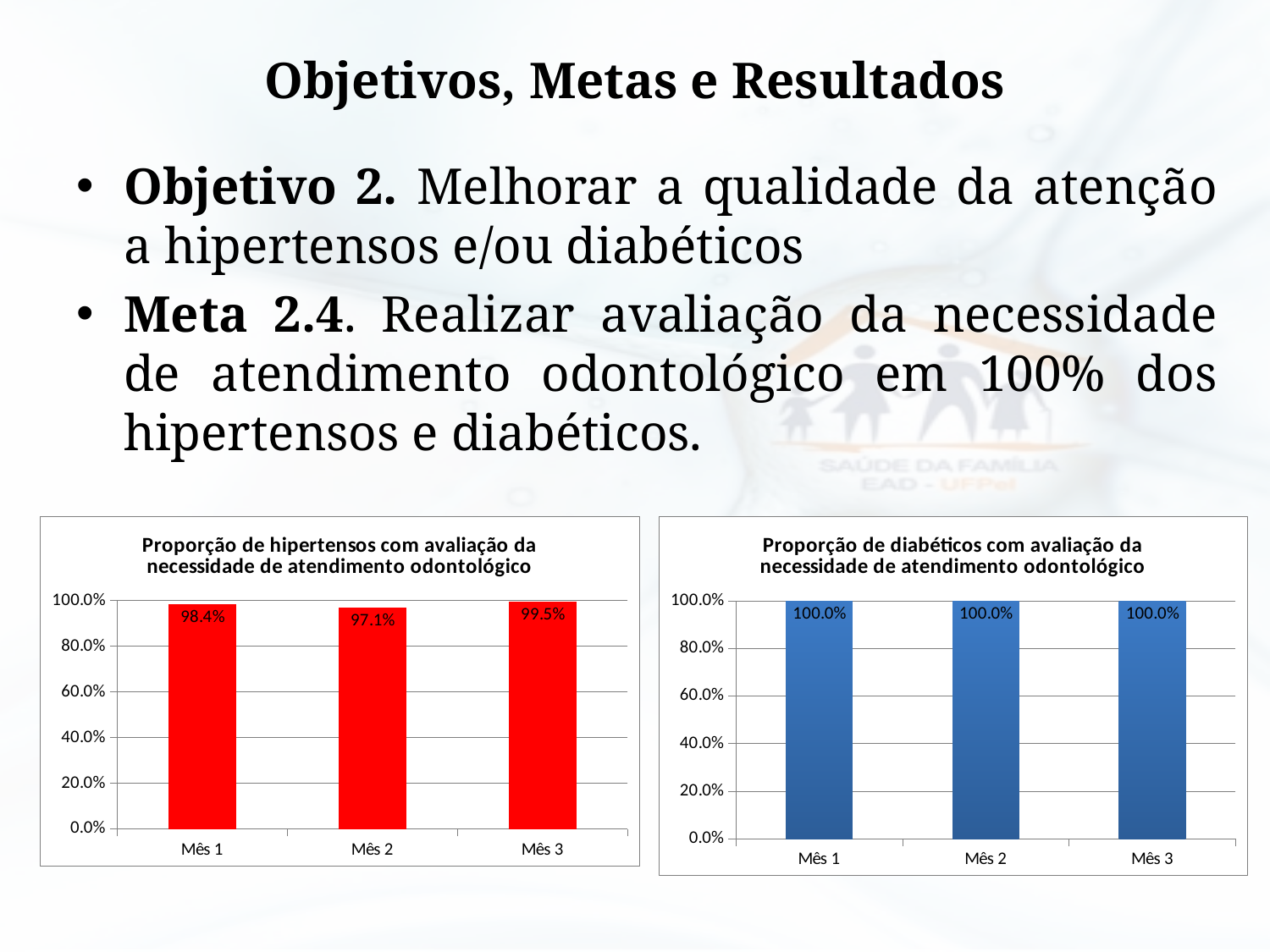
In the left chart (Proporção de hipertensos), what is the difference between the values for Mês 3 and Mês 2? 2.4% In the left chart (Proporção de hipertensos), which is larger, the value for Mês 1 or Mês 2? Mês 1 In the right chart (Proporção de diabéticos), how many months are plotted? 3 In the left chart (Proporção de hipertensos com avaliação da necessidade de atendimento odontológico), what is the value for Mês 2? 97.1% In the left chart (Proporção de hipertensos), is the value for Mês 2 greater or less than 80.0%? greater In the left chart (Proporção de hipertensos com avaliação da necessidade de atendimento odontológico), what is the value for Mês 3? 99.5% In the left chart (Proporção de hipertensos), which month has the highest value? Mês 3 In the right chart (Proporção de diabéticos com avaliação da necessidade de atendimento odontológico), what is the value for Mês 2? 100.0% What colour are the bars in the left chart (Proporção de hipertensos)? Red What kind of chart is the right chart (Proporção de diabéticos)? Bar chart In the left chart (Proporção de hipertensos), which month has the lowest value? Mês 2 In the left chart (Proporção de hipertensos com avaliação da necessidade de atendimento odontológico), what is the value for Mês 1? 98.4%